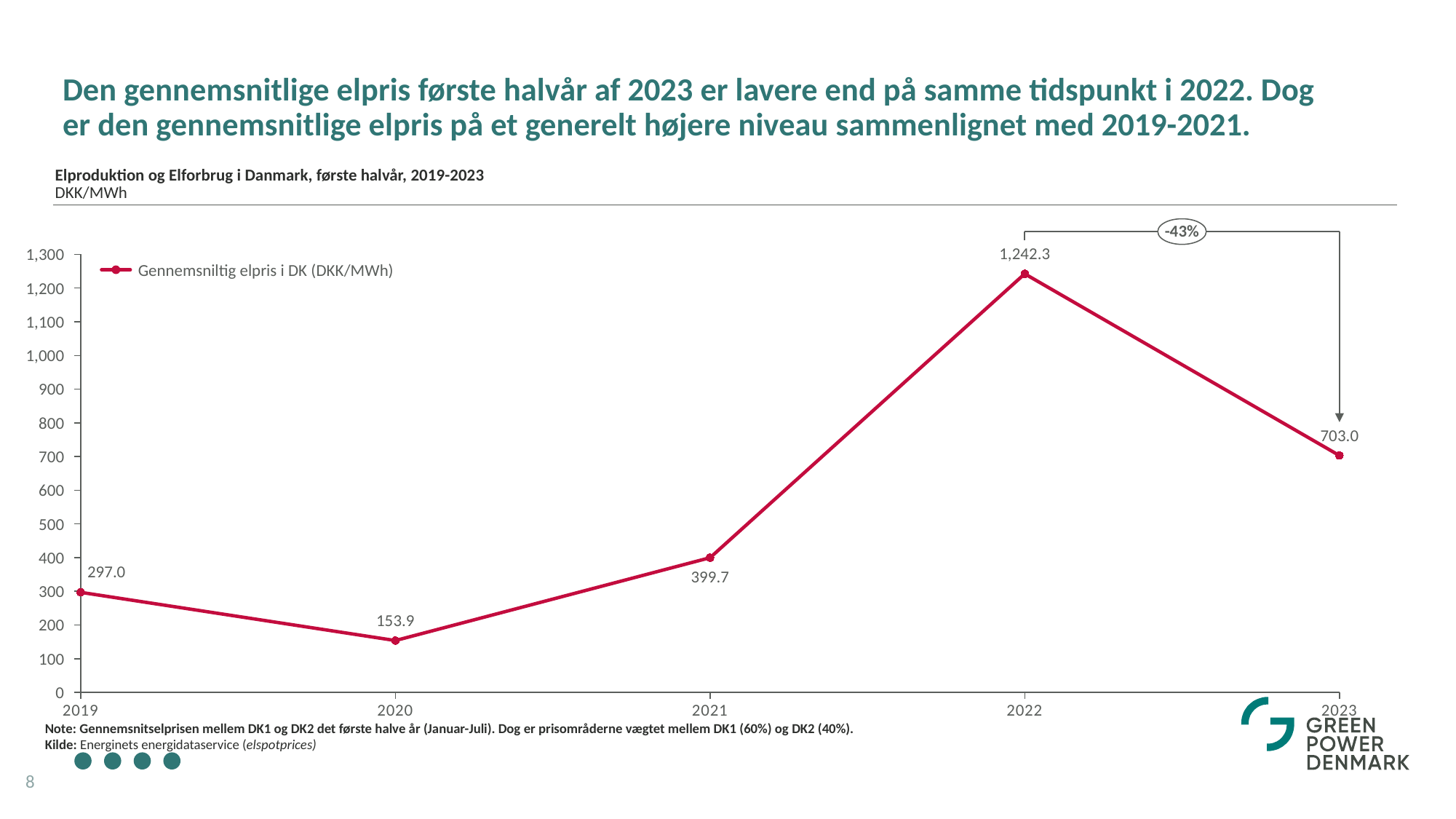
How many years are plotted on the x axis? 5 Which year has a higher value, 2019 or 2021? 2021 Does the value rise or fall from 2020 to 2022? Rise Which year has the highest average electricity price? 2022 What percentage change is annotated between 2022 and 2023? -43% What is the average electricity price in DK for 2022? 1,242.3 What is the average electricity price in DK for 2020? 153.9 What is the difference between the 2022 and 2023 values? 539.3 What is the difference between the 2019 and 2020 values? 143.1 What kind of chart is shown on the slide? Line chart What is the average electricity price in DK for 2023? 703.0 Which year has the lowest average electricity price? 2020